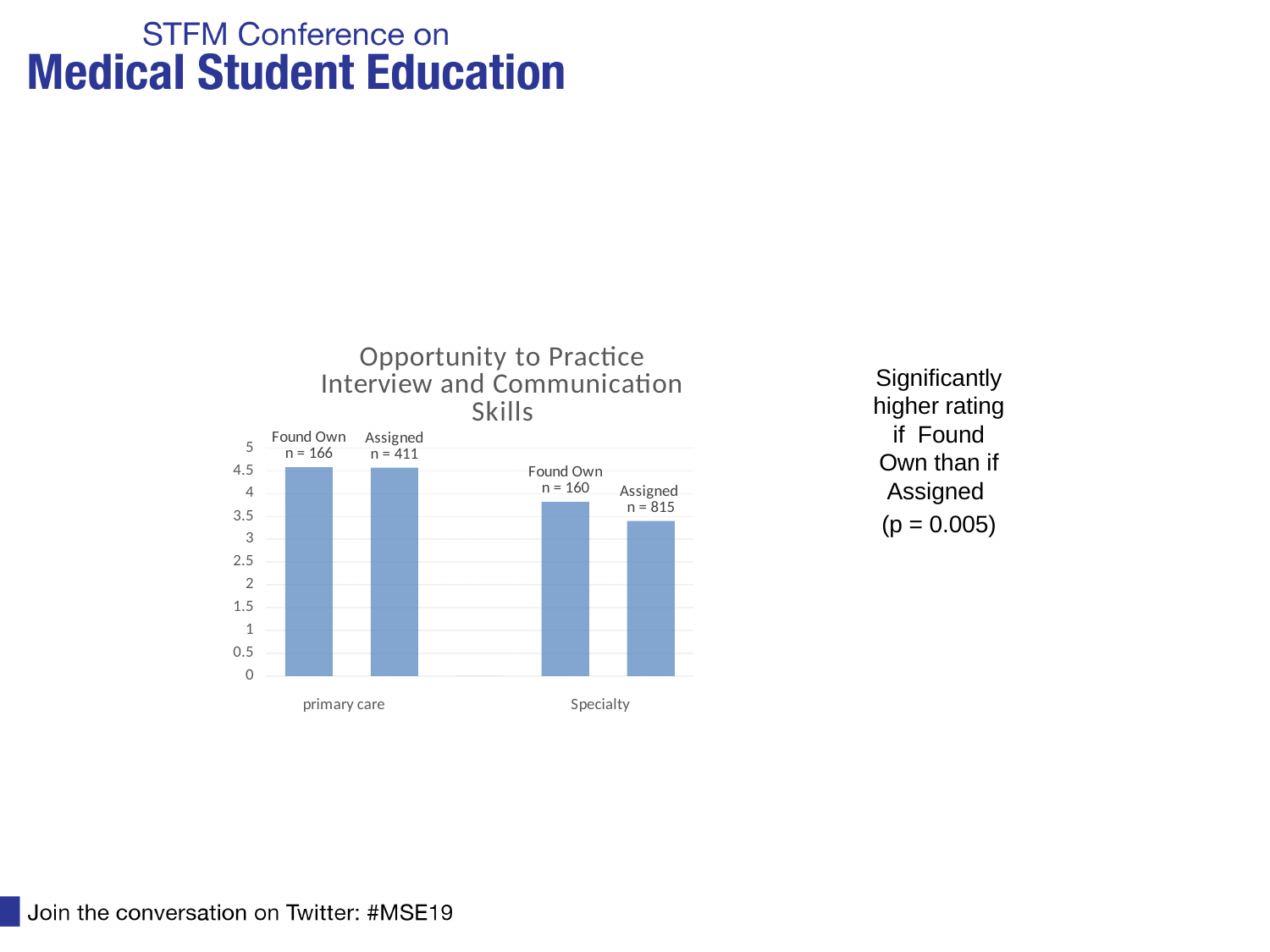
How many bars are plotted in the chart? 4 What is the maximum value shown on the y axis of the chart? 5 In the Specialty group, which bar is taller: Found Own or Assigned? Found Own What is the sample size (n) shown for the Found Own bar in the Specialty group? n = 160 What is the title of the chart? Opportunity to Practice Interview and Communication Skills What kind of chart is shown on the slide? bar chart How many groups are labelled on the x axis of the chart? 2 Is the value for the primary care Found Own bar greater or less than 4? greater What is the sample size (n) shown for the Assigned bar in the Specialty group? n = 815 Which bar has the lowest value in the chart? Specialty Assigned What is the sample size (n) shown for the Found Own bar in the primary care group? n = 166